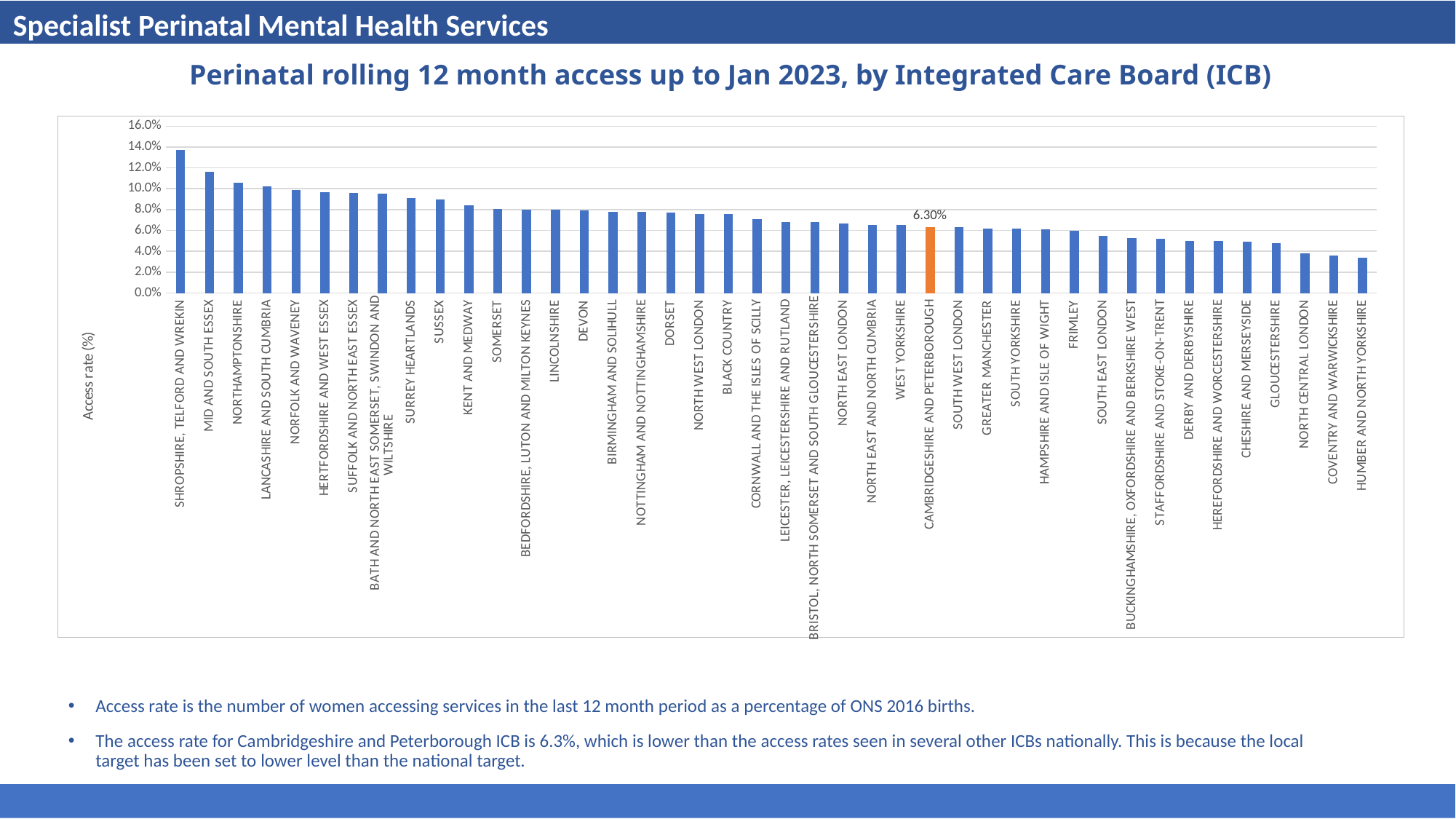
Is the access rate for Humber and North Yorkshire greater or less than 4.0%? less Which has a higher access rate, Sussex or North Central London? Sussex Is the access rate for Mid and South Essex greater or less than 10.0%? greater What type of chart is shown on the slide? Bar chart Which ICB has the lowest access rate? Humber and North Yorkshire Is the access rate for Shropshire, Telford and Wrekin greater or less than 12.0%? greater What is the access rate shown for Cambridgeshire and Peterborough? 6.30% How many ICBs are shown on the chart? 42 Which has a higher access rate, Northamptonshire or Frimley? Northamptonshire Which ICB's bar is highlighted in orange? Cambridgeshire and Peterborough Which ICB has the highest access rate? Shropshire, Telford and Wrekin